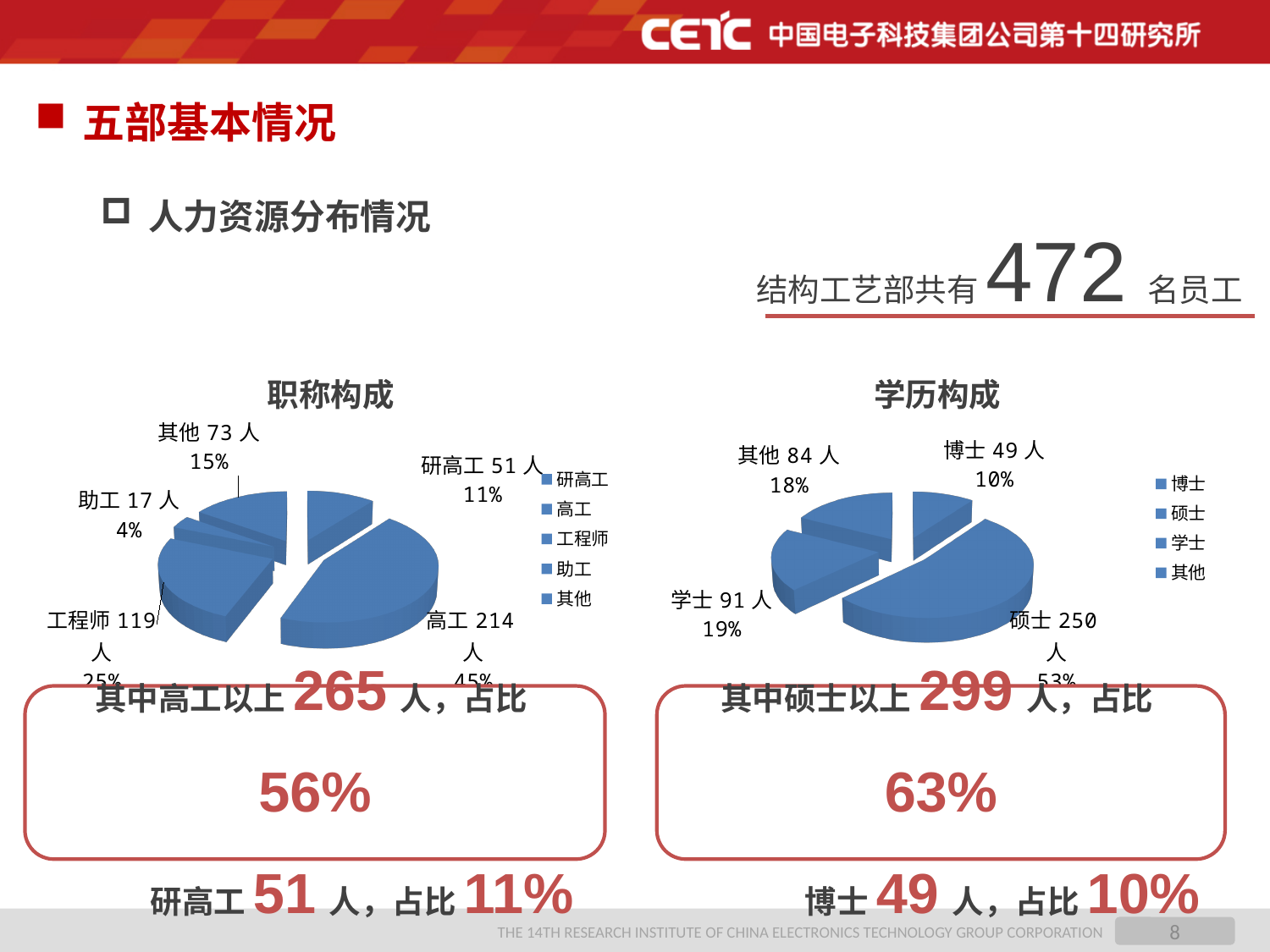
In the 学历构成 chart, what share of the pie is 学士? 19% In the 职称构成 chart, how many people are 高工? 214 人 In the 职称构成 chart, how many more people are 工程师 than 研高工? 68 In the 学历构成 chart, which is larger, 学士 or 其他? 学士 What type of chart is the 学历构成 chart? Pie chart In the 职称构成 chart, which category has the largest slice? 高工 In the 学历构成 chart, which category has the largest slice? 硕士 In the 职称构成 chart, which category has the smallest slice? 助工 In the 学历构成 chart, how many people are 博士? 49 人 How many categories does the 职称构成 pie chart have? 5 How many entries does the legend of the 学历构成 chart list? 4 In the 职称构成 chart, what share of the pie is 其他? 15%